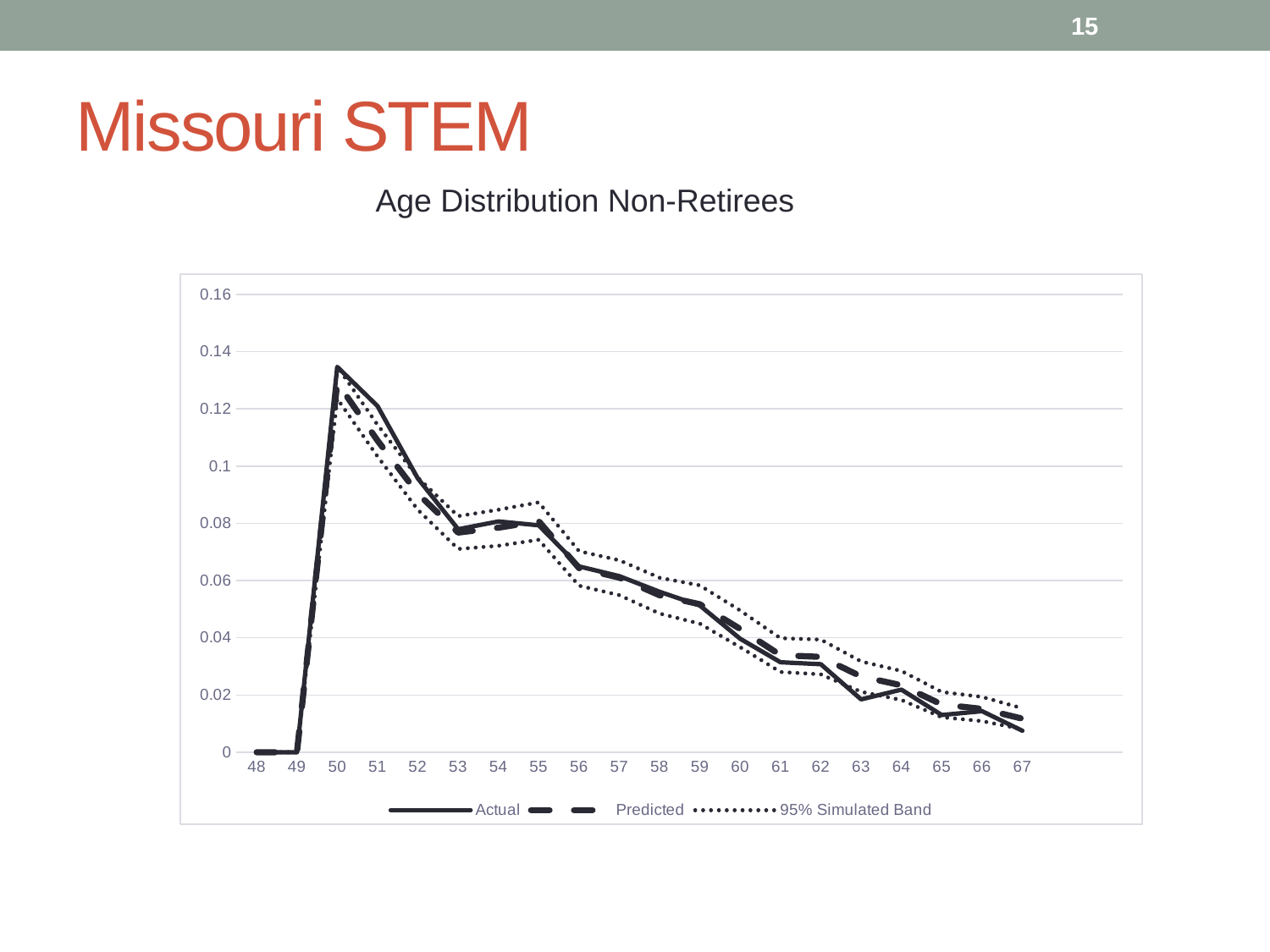
How many series does the legend list? 3 From age 50 to age 67, does the Actual series generally rise or fall? fall Is the Actual value at age 63 greater or less than 0.04? less Is the Actual value at age 67 greater or less than 0.02? less Which is larger, the Actual value at age 50 or at age 55? age 50 Is the Actual value at age 50 greater or less than 0.12? greater At which age does the Actual series reach its highest value? 50 What is the title of the chart? Age Distribution Non-Retirees How many ages are shown along the x axis? 20 What kind of chart is shown on the slide? line chart What is the Actual value at age 48? 0